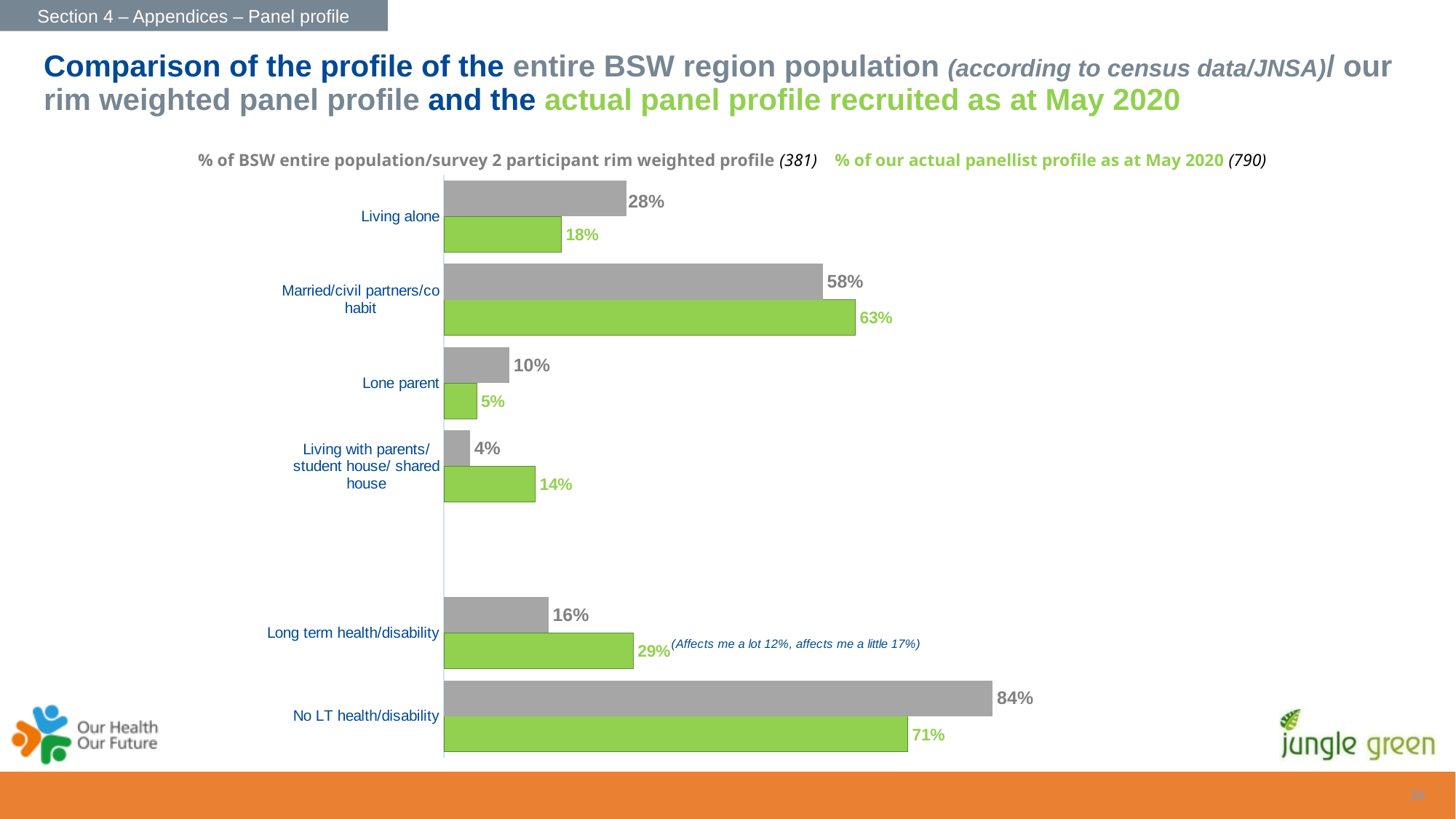
What kind of chart is shown on the slide? Bar chart Which category has the highest value in the % of our actual panellist profile as at May 2020 series? No LT health/disability What is the difference between the two series' values for No LT health/disability? 13% What is the value for Living alone in the % of BSW entire population/survey 2 participant rim weighted profile series? 28% What is the value for Lone parent in the % of our actual panellist profile as at May 2020 series? 5% How many categories are shown in the chart? 6 What colour are the bars for the % of our actual panellist profile as at May 2020 series? Green How many series does the chart legend list? 2 For Living with parents/ student house/ shared house, which series has the larger value? % of our actual panellist profile as at May 2020 Which category has the lowest value in the % of BSW entire population/survey 2 participant rim weighted profile series? Living with parents/ student house/ shared house What is the value for Married/civil partners/co habit in the % of our actual panellist profile as at May 2020 series? 63% What is the value for Long term health/disability in the % of BSW entire population/survey 2 participant rim weighted profile series? 16%